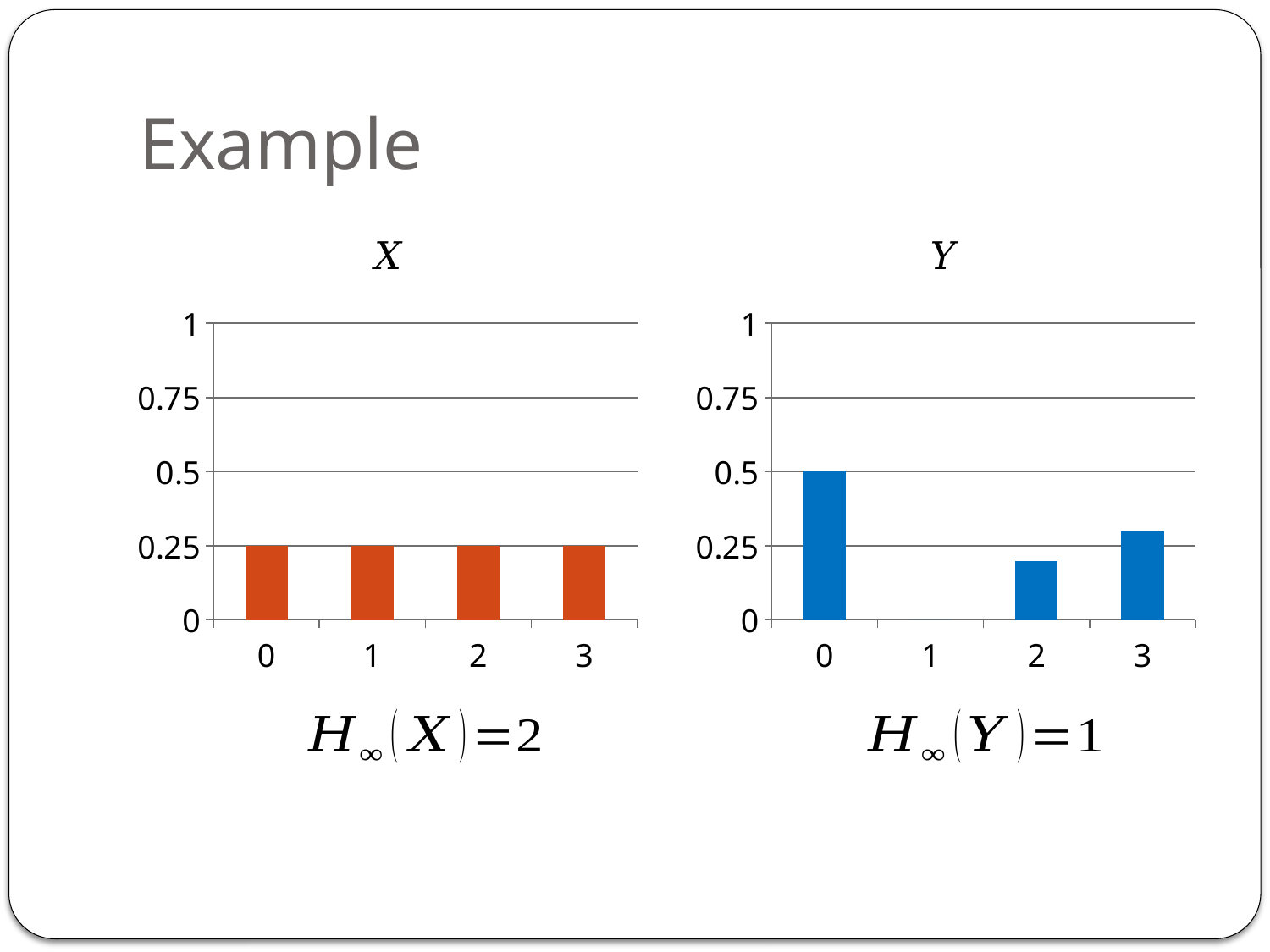
In the chart titled Y, is the value for category 3 greater or less than 0.25? greater In the chart titled Y, is the value for category 2 greater or less than 0.25? less In the chart titled Y, what is the value for category 0? 0.5 How many categories are shown on the x axis of the chart titled X? 4 In the chart titled Y, which category has the highest value? 0 In the chart titled X, what is the value for category 0? 0.25 In the chart titled X, do the values rise, fall, or stay flat from category 0 to category 3? stay flat In the chart titled X, what is the value for category 3? 0.25 In the chart titled Y, which category has the lowest value? 1 What type of chart is the chart titled X? bar chart What colour are the bars in the chart titled Y? blue In the chart titled Y, which is larger: the value for category 0 or the value for category 3? category 0